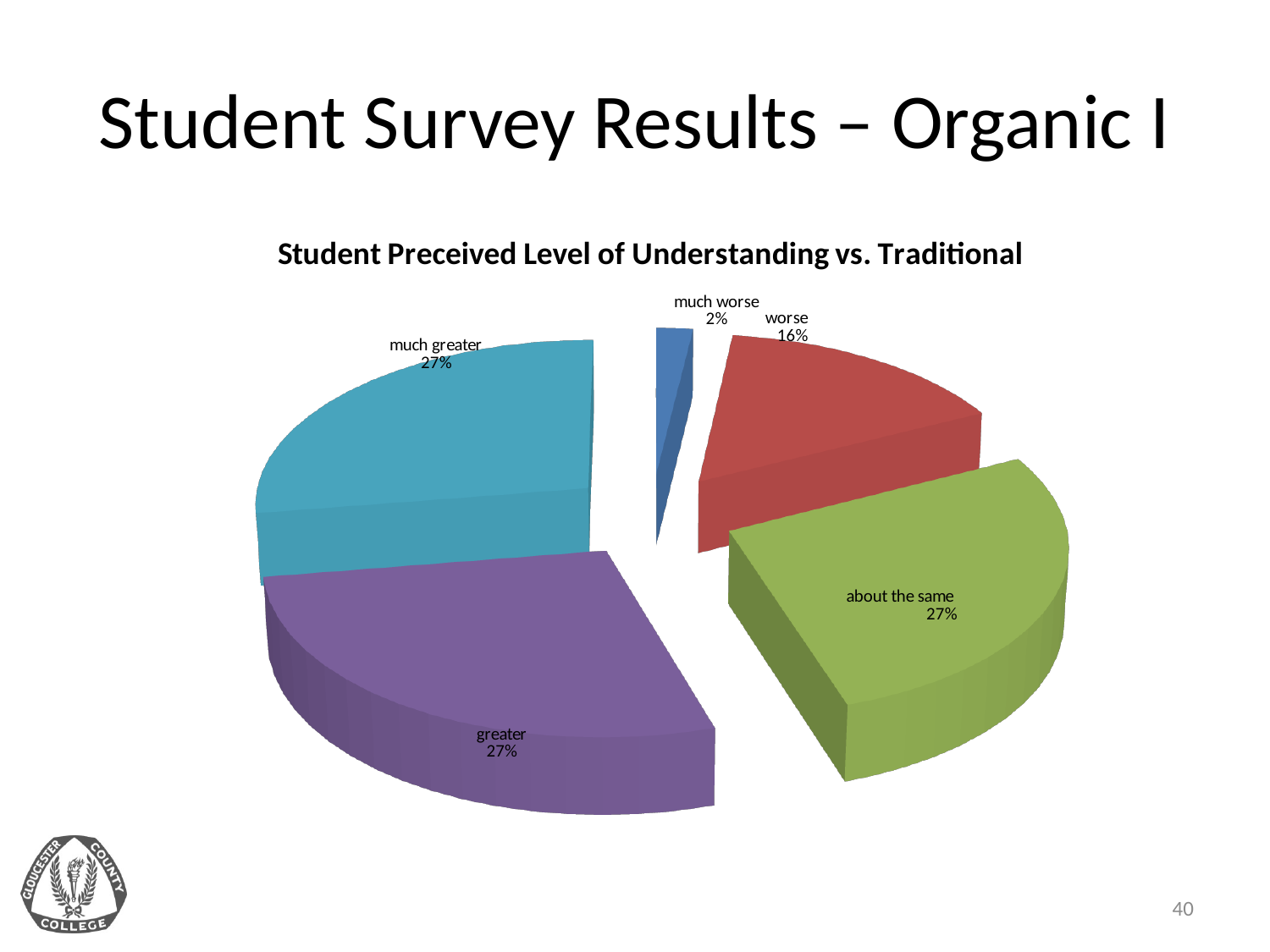
How many slices does the pie chart have? 5 What share of the pie is labelled "greater"? 27% What is the difference in percentage points between the "about the same" slice and the "worse" slice? 11 What share of the pie is labelled "about the same"? 27% Which is larger, the "worse" slice or the "much worse" slice? worse What share of the pie is labelled "much worse"? 2% Which category has the smallest slice of the pie? much worse What colour is the "greater" slice? purple What kind of chart is shown on the slide? pie chart What is the title of the chart? Student Preceived Level of Understanding vs. Traditional